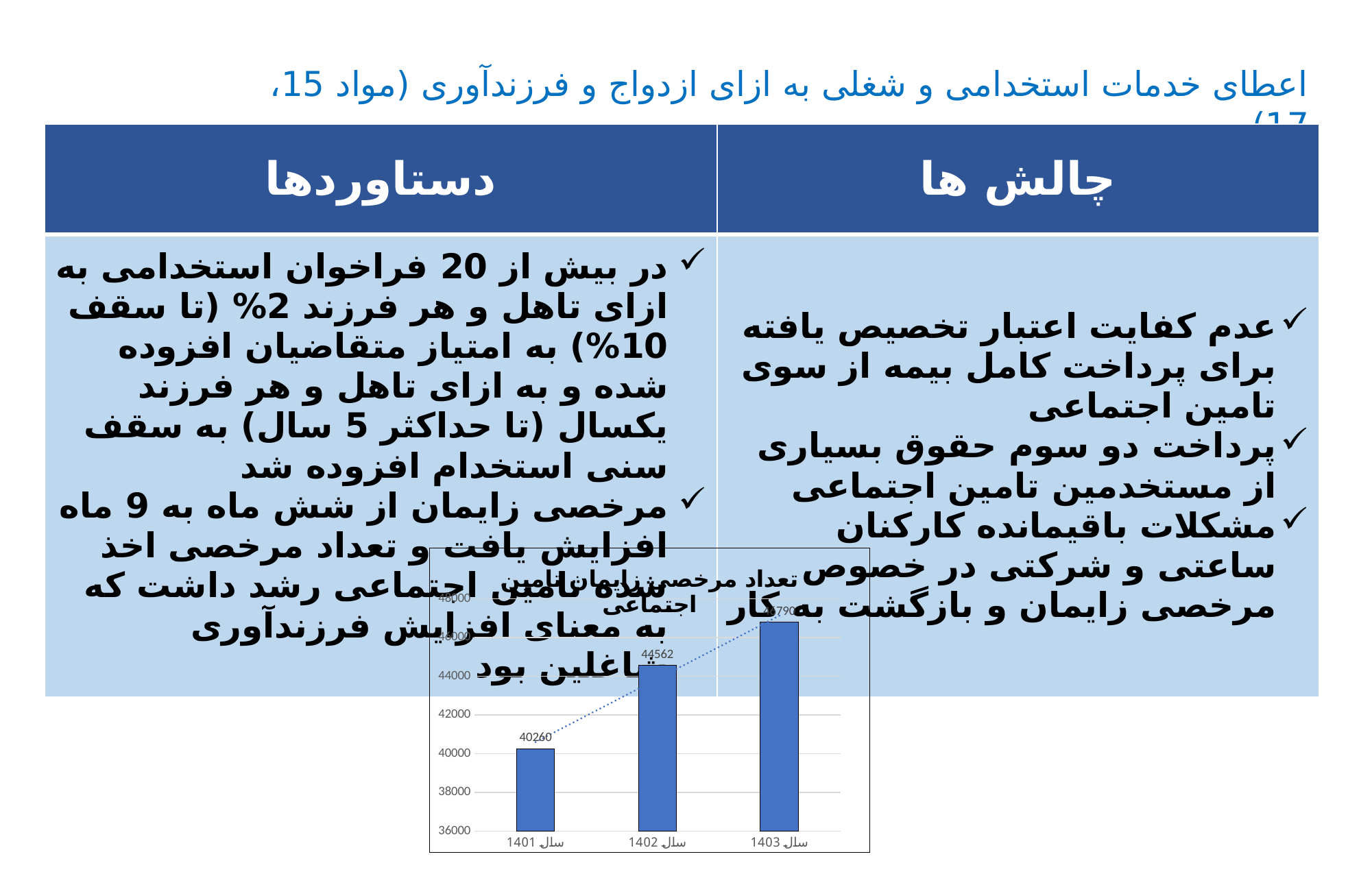
Which year has the lowest bar in the chart? سال 1401 Which year has the highest bar in the chart? سال 1403 Do the values rise or fall from سال 1401 to سال 1403? rise Is the value for سال 1403 greater or less than 46000? greater What is the value shown for سال 1401? 40260 How many years (categories) are plotted in the chart? 3 What type of chart is shown on the slide? bar chart Is the value for سال 1401 greater or less than 42000? less Which is larger, the value for سال 1402 or the value for سال 1401? سال 1402 What colour are the bars in the chart? blue What is the value shown for سال 1402? 44562 What is the difference between the values for سال 1402 and سال 1401? 4302